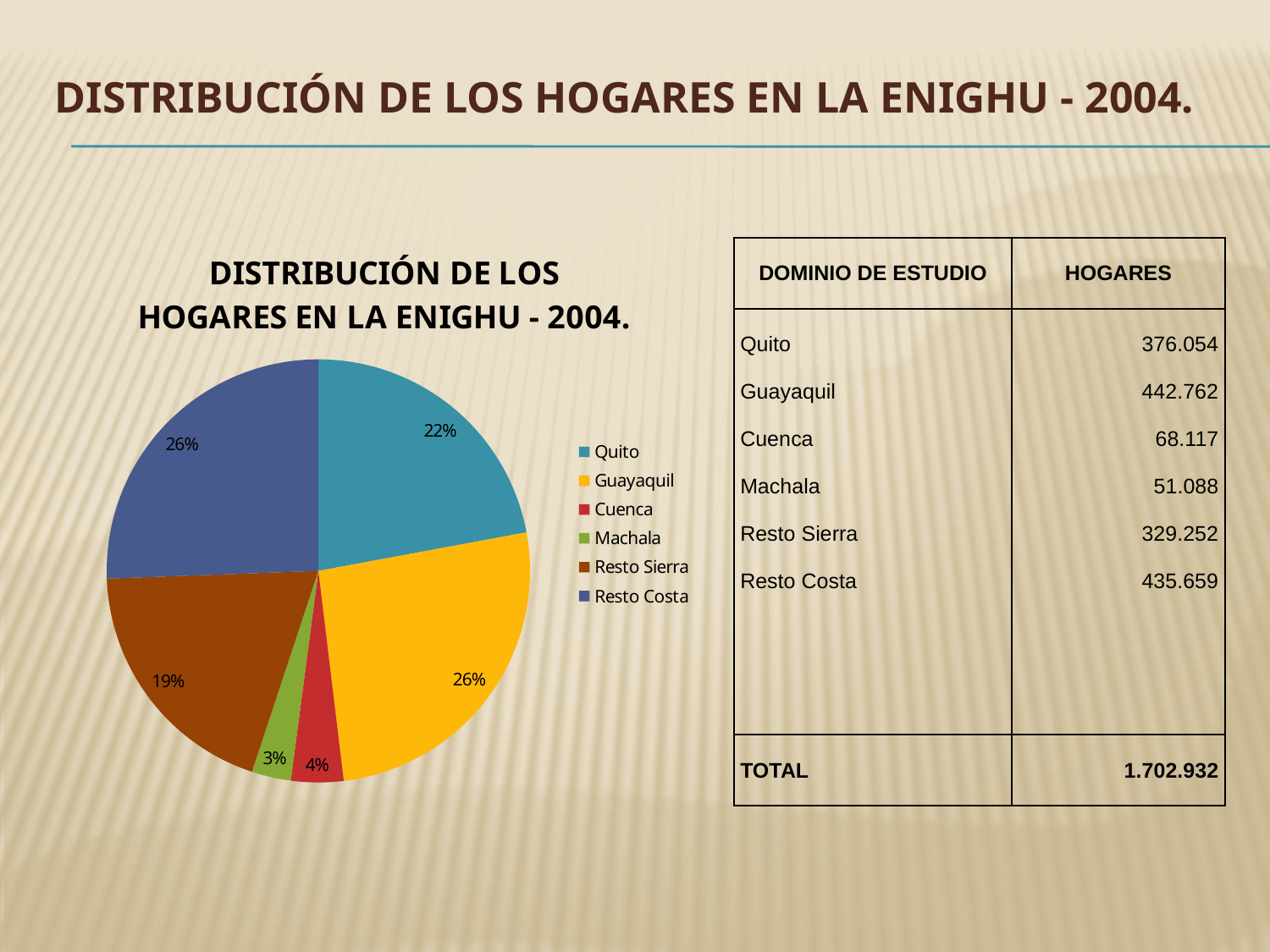
How many slices does the pie chart have? 6 What share of the pie does Guayaquil represent? 26% What share of the pie does Machala represent? 3% What kind of chart is shown on the slide? pie chart What share of the pie does Quito represent? 22% Which category has the smallest slice of the pie? Machala What is the title of the pie chart? DISTRIBUCIÓN DE LOS HOGARES EN LA ENIGHU - 2004. Which slice is larger, Quito or Resto Sierra? Quito What is the difference in percentage points between the Quito slice and the Resto Sierra slice? 3